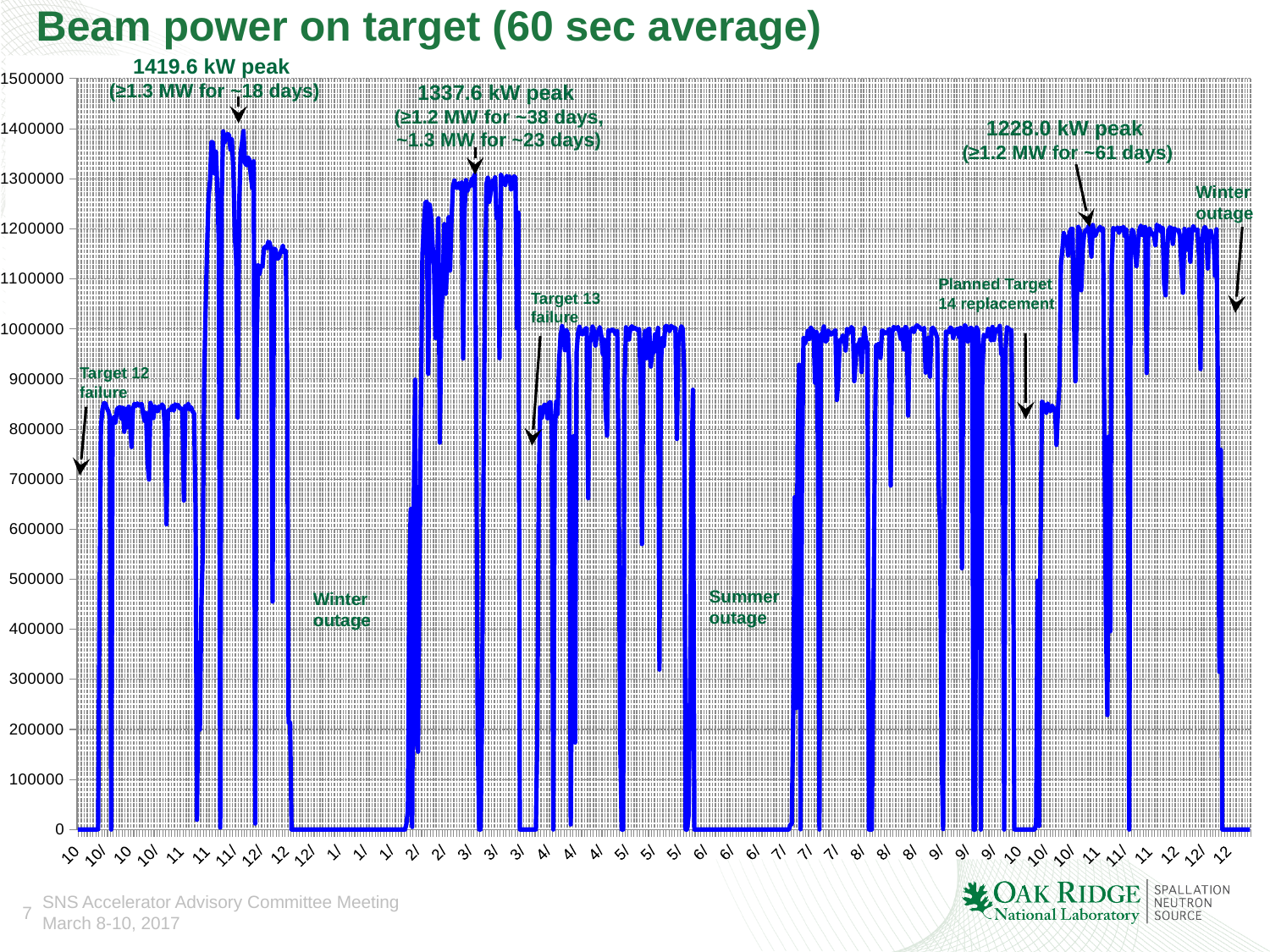
Is the plateau of beam power just after the Target 12 failure greater or less than 800000? greater Is the plateau of beam power in the period between the Target 13 failure and the Summer outage greater or less than 900000? greater What is the difference between the 1419.6 kW peak and the 1228.0 kW peak? 191.6 kW What is the lowest of the three annotated peak beam power values? 1228.0 kW What is the highest peak beam power annotated on the chart? 1419.6 kW For how many days was the beam power at or above 1.2 MW during the run with the 1228.0 kW peak, according to the annotation? ~61 days What kind of chart is shown on the slide? line chart What is the title of the chart? Beam power on target (60 sec average) Which annotated peak is larger, the 1337.6 kW peak or the 1228.0 kW peak? 1337.6 kW peak What is the difference between the 1419.6 kW peak and the 1337.6 kW peak? 82.0 kW What peak value is annotated for the run period in the middle of the chart (around 2/ to 3/)? 1337.6 kW How many outages (winter or summer) are labeled on the chart? 3